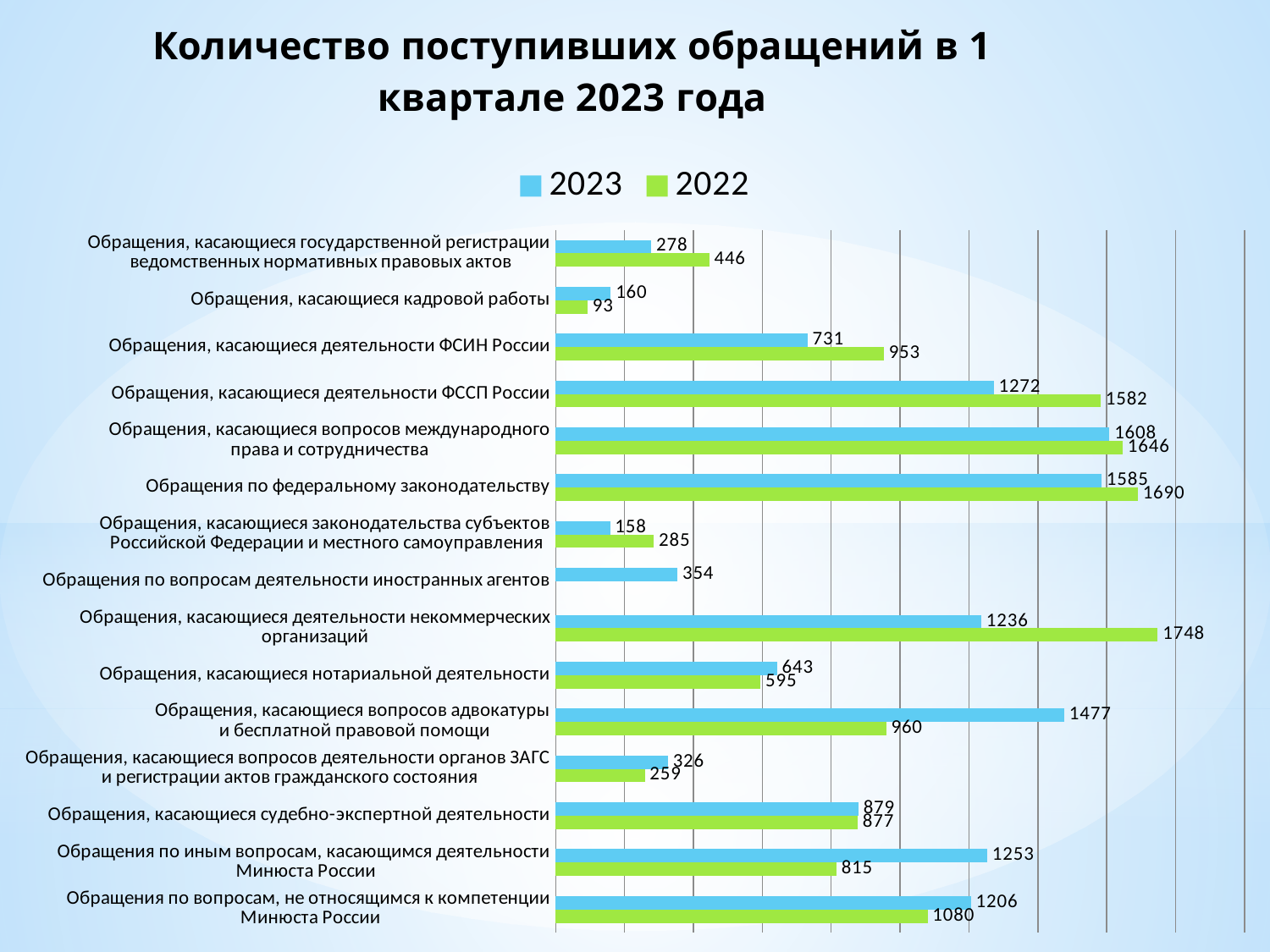
Which category has the highest 2023 value? Обращения, касающиеся вопросов международного права и сотрудничества What type of chart is shown on the slide? bar chart Which category has the lowest 2022 value? Обращения, касающиеся кадровой работы How many categories are shown on the chart? 15 What is the 2022 value for «Обращения, касающиеся деятельности некоммерческих организаций»? 1748 Which category has the highest 2022 value? Обращения, касающиеся деятельности некоммерческих организаций For «Обращения, касающиеся деятельности ФССП России», which year has the larger value, 2023 or 2022? 2022 Which colour represents the 2022 series in the chart? green What is the 2023 value for «Обращения, касающиеся деятельности ФСИН России»? 731 What is the 2023 value for «Обращения по вопросам деятельности иностранных агентов»? 354 What is the difference between the 2023 and 2022 values for «Обращения, касающиеся вопросов адвокатуры и бесплатной правовой помощи»? 517 How many series does the legend list? 2